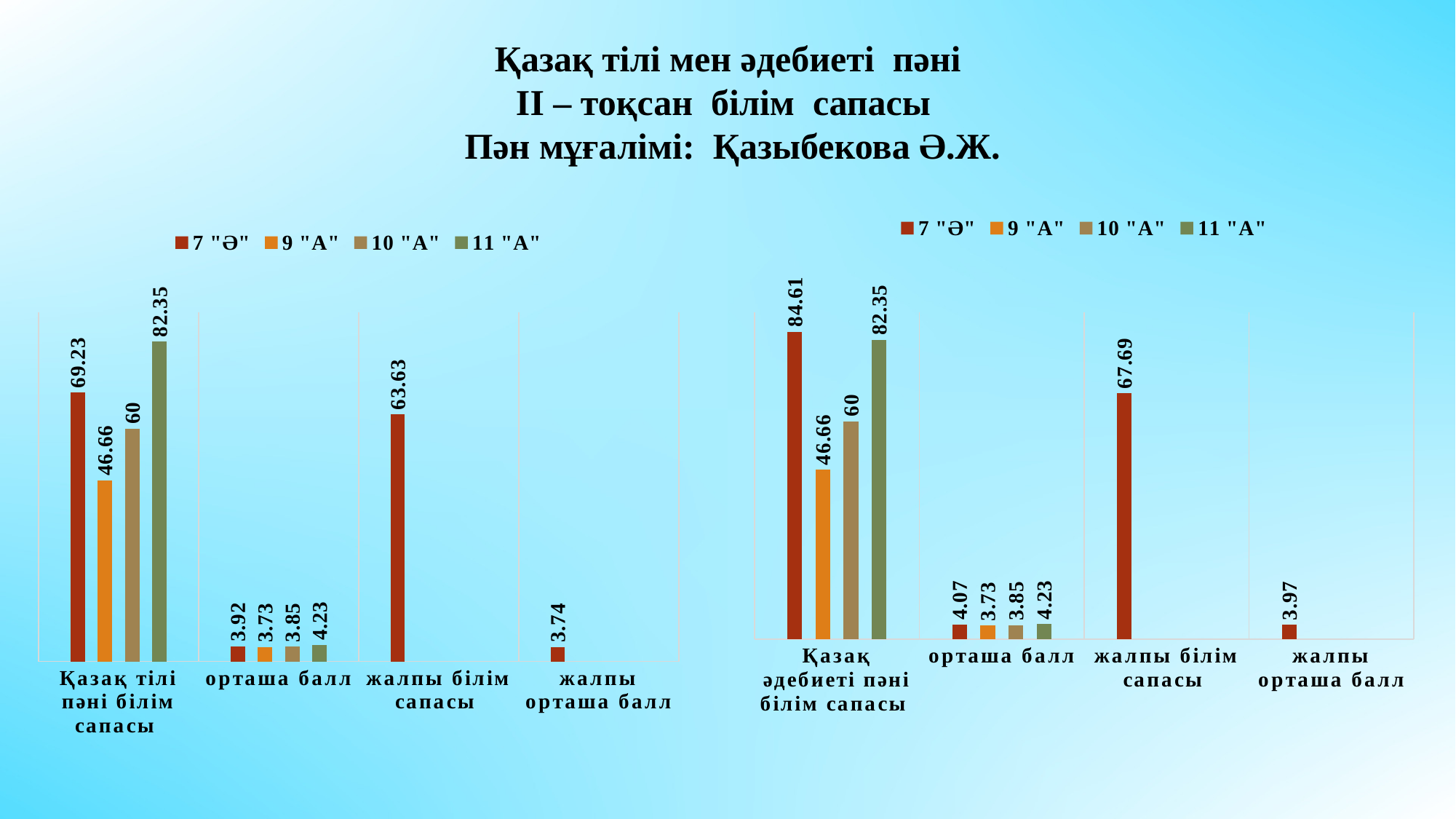
On the right chart, which series has the lowest value in the category "Қазақ әдебиеті пәні білім сапасы"? 9 "А" On the left chart, which series has the highest value in the category "Қазақ тілі пәні білім сапасы"? 11 "А" On the left chart, what is the value for 7 "Ә" in the category "Қазақ тілі пәні білім сапасы"? 69.23 What kind of chart is the left chart? Bar chart On the right chart, what is the value for 7 "Ә" in the category "орташа балл"? 4.07 How many categories are shown on the x axis of the right chart? 4 On the right chart, what is the value for 7 "Ә" in the category "Қазақ әдебиеті пәні білім сапасы"? 84.61 On the right chart, which is larger in the category "Қазақ әдебиеті пәні білім сапасы": the value for 7 "Ә" or the value for 10 "А"? 7 "Ә" On the left chart, what is the value for "жалпы білім сапасы"? 63.63 How many series does the legend of the left chart list? 4 On the left chart, what is the difference between the 11 "А" and 9 "А" values in the category "Қазақ тілі пәні білім сапасы"? 35.69 On the right chart, what is the value for "жалпы орташа балл"? 3.97